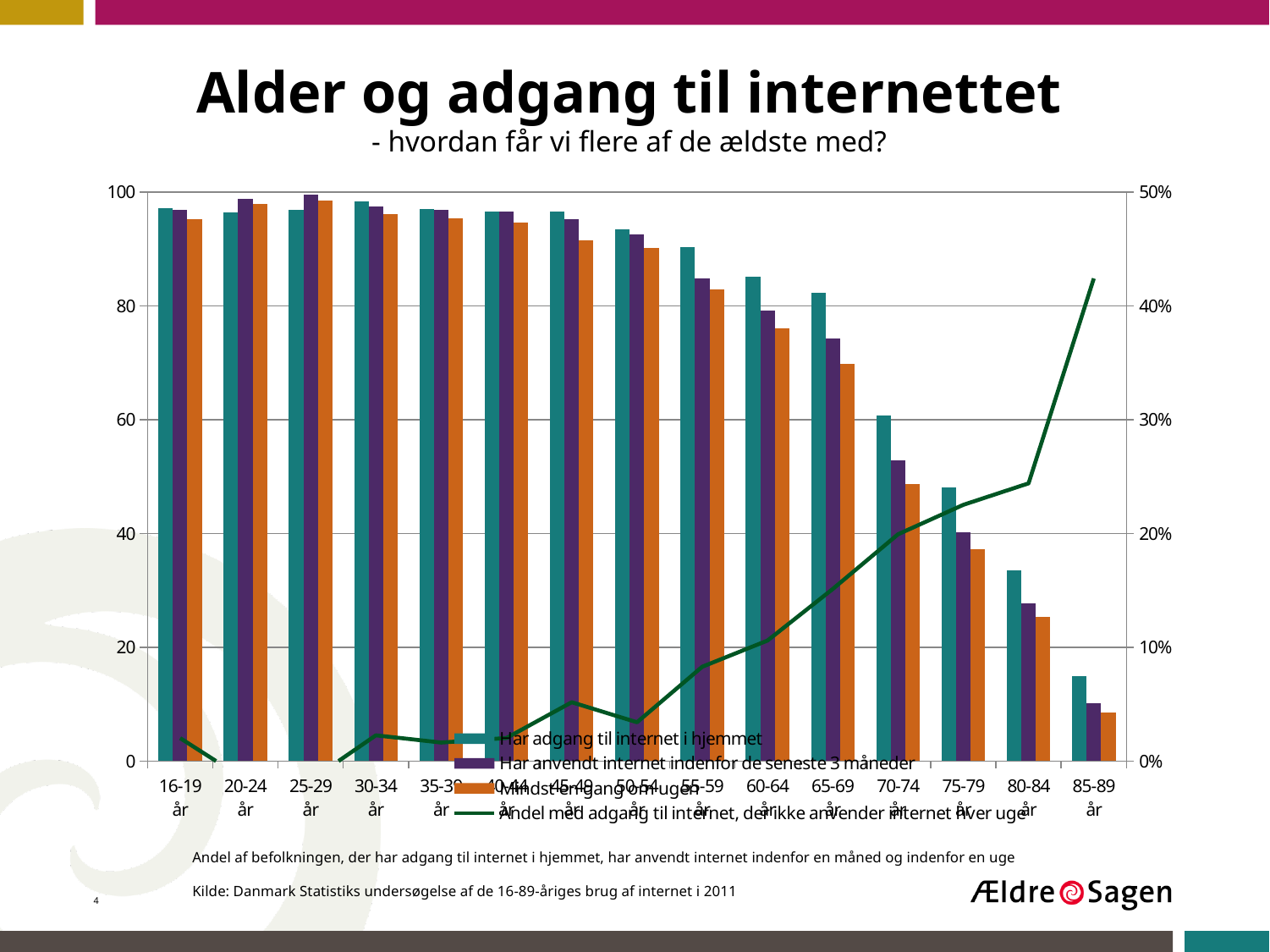
How many age groups are shown on the x axis? 15 How many series does the legend list? 4 Is the value for 'Har adgang til internet i hjemmet' for 85-89 år greater or less than 20? less What is the title of the chart? Alder og adgang til internettet Which age group has the lowest value for 'Har adgang til internet i hjemmet'? 85-89 år Is the value of the line 'Andel med adgang til internet, der ikke anvender internet hver uge' for 85-89 år greater or less than 40%? greater Is the value for 'Har adgang til internet i hjemmet' for 75-79 år greater or less than 40? greater Which is larger for 'Har adgang til internet i hjemmet': 16-19 år or 85-89 år? 16-19 år Which is larger for 'Mindst en gang om ugen': 60-64 år or 70-74 år? 60-64 år What kind of chart is this? A bar chart combined with a line chart Do the bar values for 'Har adgang til internet i hjemmet' generally rise or fall as age increases along the x axis? fall